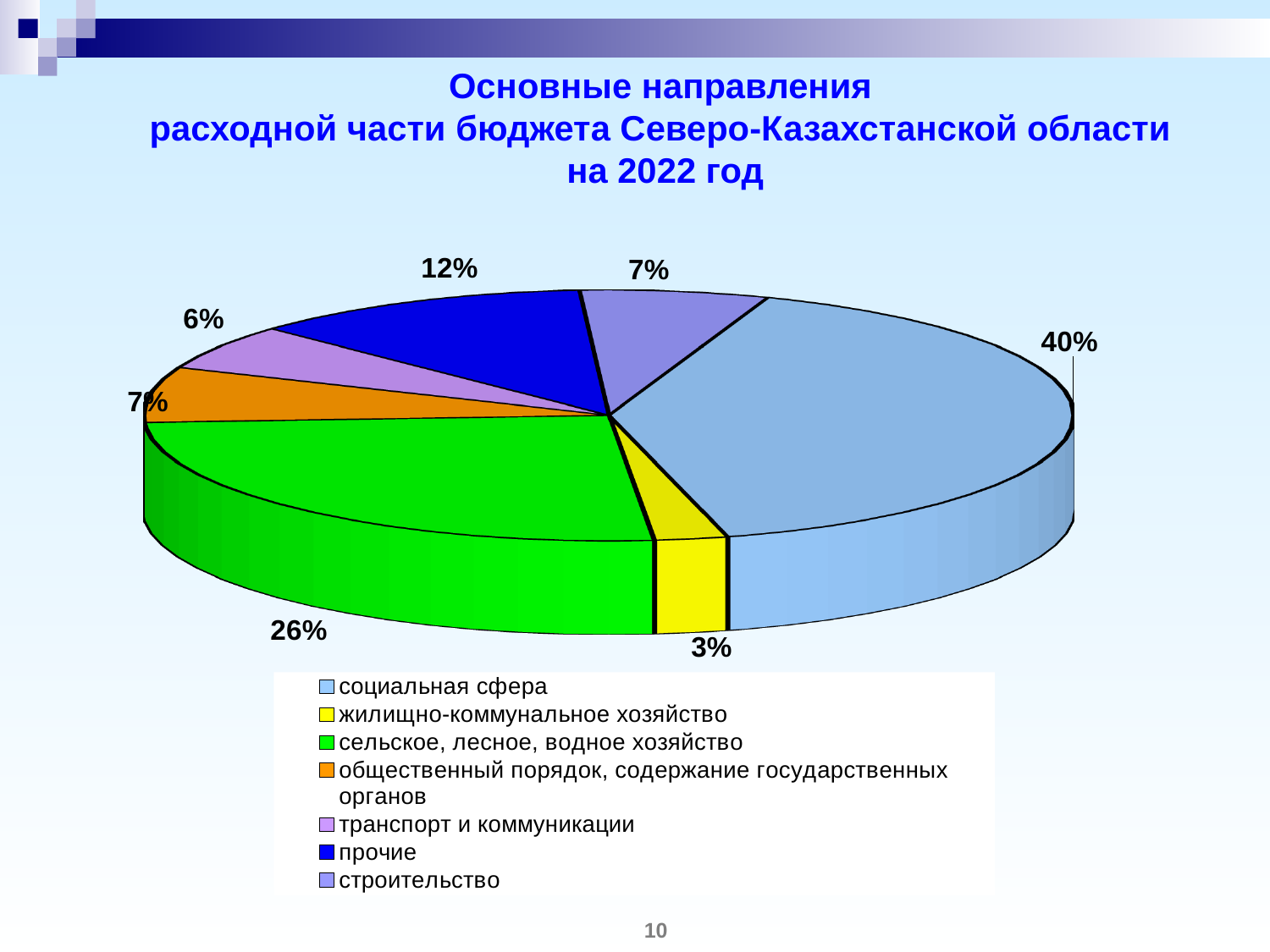
Which has a larger share: прочие or транспорт и коммуникации? прочие Which category has the smallest share of the budget expenditure? жилищно-коммунальное хозяйство What share of the budget expenditure goes to социальная сфера? 40% What kind of chart is shown on the slide? pie chart Which category has the largest share of the budget expenditure? социальная сфера How many categories does the pie chart show? 7 What colour is the slice for сельское, лесное, водное хозяйство? green What is the difference in percentage points between the shares of социальная сфера and сельское, лесное, водное хозяйство? 14 What share of the budget expenditure goes to жилищно-коммунальное хозяйство? 3% What share of the budget expenditure goes to сельское, лесное, водное хозяйство? 26%